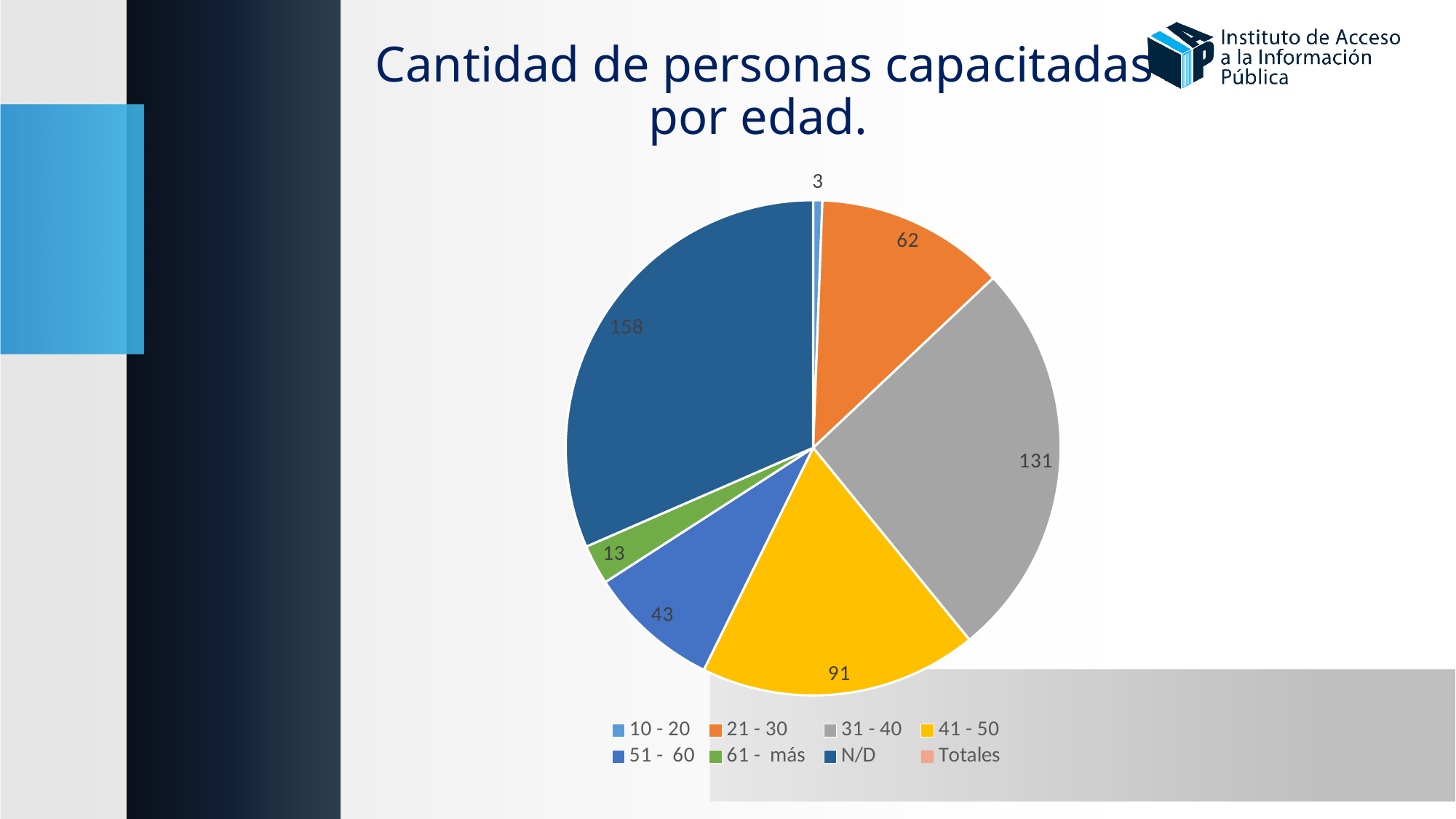
What is the difference between the values for 31 - 40 and 41 - 50? 40 What is the value for the 61 - más age group? 13 What is the value for the 10 - 20 age group? 3 What type of chart is shown on the slide? pie chart What is the title of the chart? Cantidad de personas capacitadas por edad. Which is larger, the value for 21 - 30 or the value for 51 - 60? 21 - 30 What is the value for the 31 - 40 age group? 131 What colour is the slice for the 41 - 50 age group? yellow Which category has the smallest slice? 10 - 20 How many entries does the legend list? 8 Which category has the largest slice? N/D What is the value for the N/D category? 158